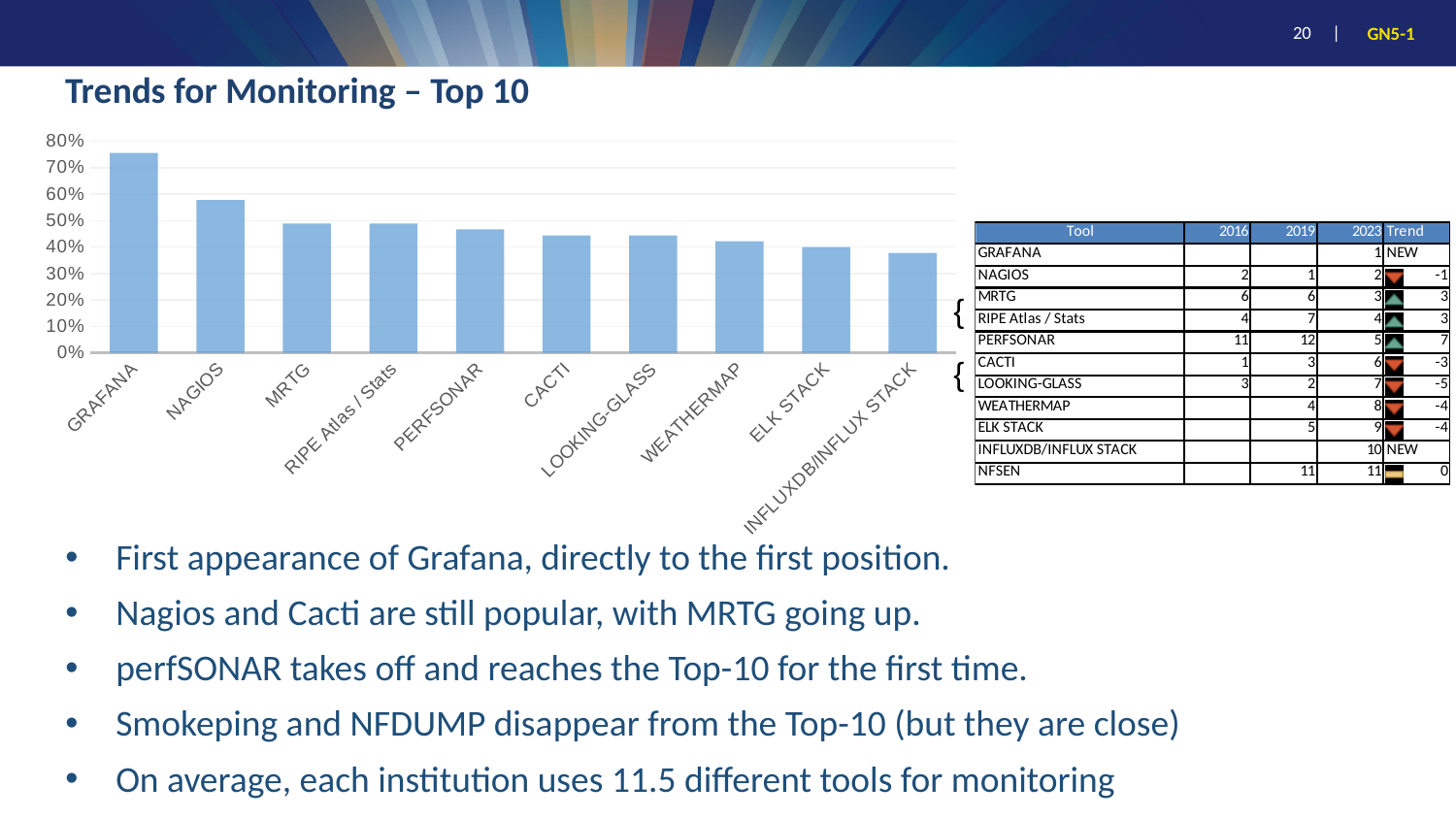
Is the value for NAGIOS greater or less than 50%? greater Is the value for GRAFANA greater or less than 70%? greater Do the bar values rise or fall from left to right along the x axis? fall How many tools are plotted as bars in the chart? 10 Which has a larger value, GRAFANA or NAGIOS? GRAFANA Is the value for ELK STACK greater or less than 50%? less Which tool has the highest bar in the chart? GRAFANA Which tool has the lowest bar in the chart? INFLUXDB/INFLUX STACK Which has a larger value, MRTG or ELK STACK? MRTG What is the title of the slide containing the chart? Trends for Monitoring – Top 10 What kind of chart is shown on the slide? bar chart